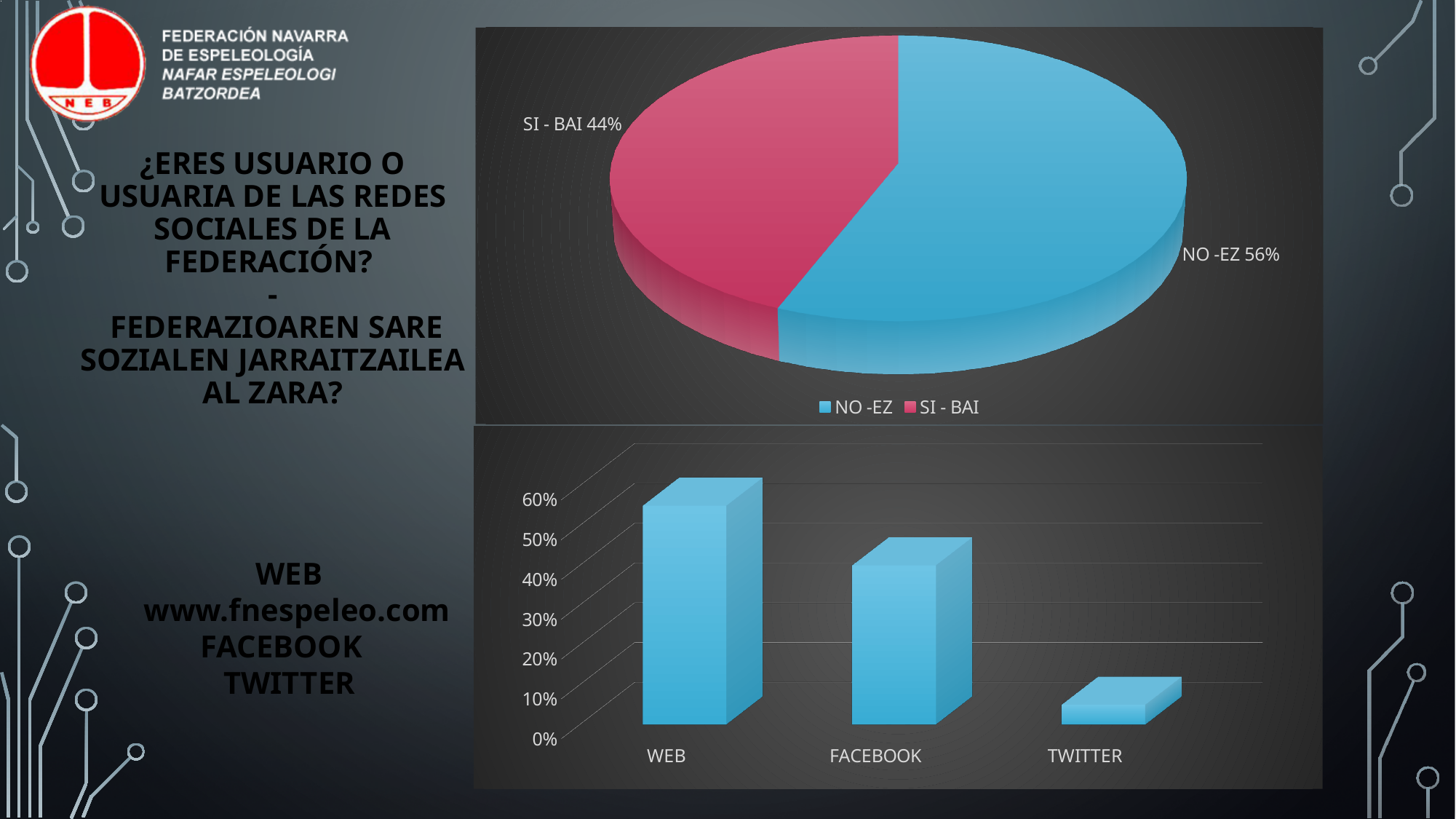
In the bar chart at the bottom, which category has the highest value? WEB In the pie chart at the top, what percentage is shown for NO -EZ? 56% In the pie chart at the top, what percentage is shown for SI - BAI? 44% In the pie chart at the top, what colour is the SI - BAI slice? pink/red In the pie chart at the top, which slice is larger, NO -EZ or SI - BAI? NO -EZ What kind of chart is the bottom chart on the slide? bar chart What kind of chart is the top chart on the slide? pie chart How many entries does the legend of the pie chart at the top list? 2 In the bar chart at the bottom, is the value for TWITTER greater or less than 10%? less In the bar chart at the bottom, which category has the lowest value? TWITTER How many categories are shown in the bar chart at the bottom? 3 In the pie chart at the top, what is the difference in percentage points between NO -EZ and SI - BAI? 12